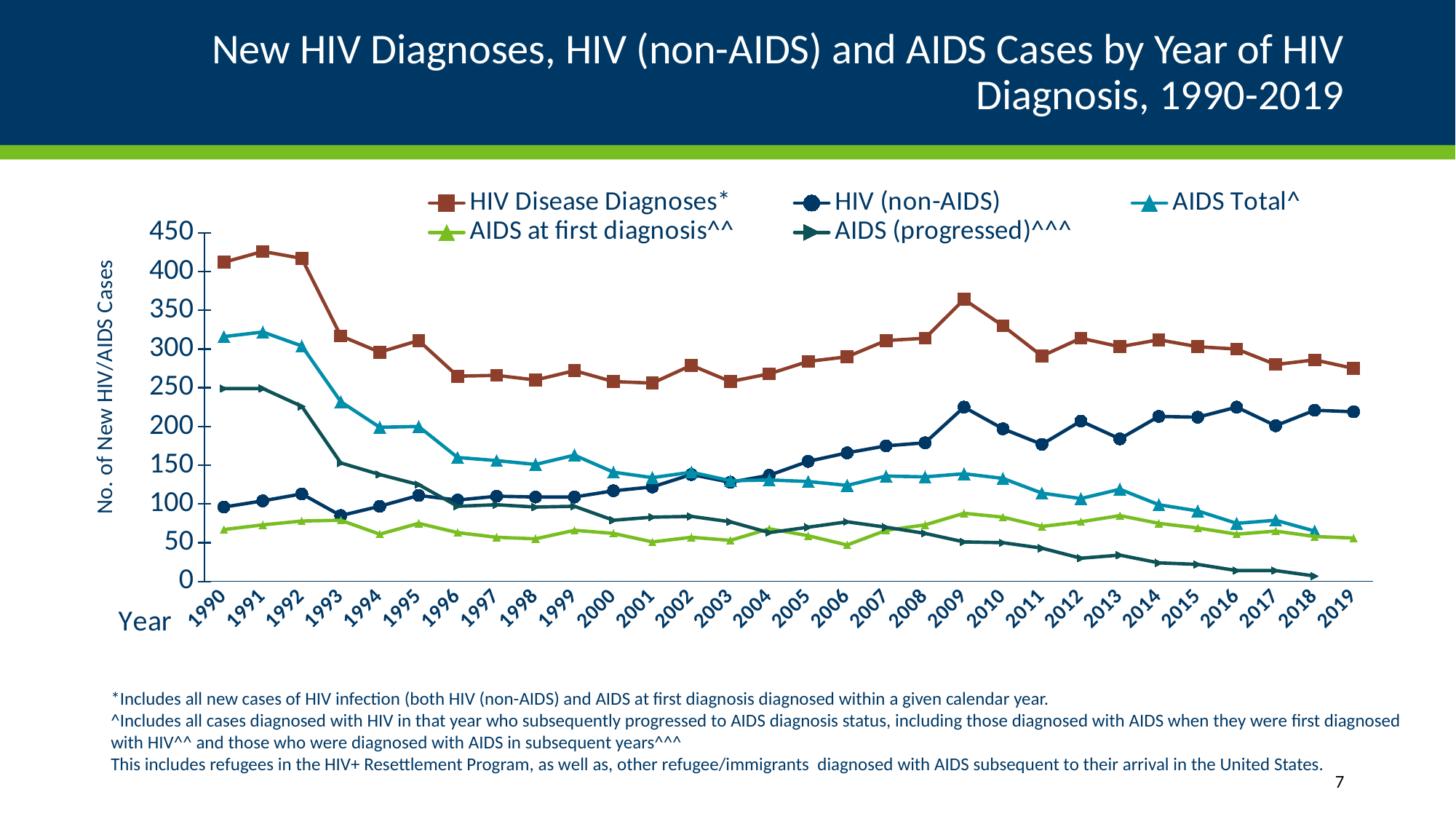
Is the value for HIV (non-AIDS) in 2009 greater or less than 200? greater What kind of chart is shown on the slide? line chart In which year is the HIV Disease Diagnoses* series at its highest? 1991 Is the value for HIV Disease Diagnoses* in 1990 greater or less than 400? greater How many years are plotted along the x axis? 30 Does the HIV (non-AIDS) series rise or fall from 1990 to 2019? rise Does the AIDS (progressed)^^^ series rise or fall from 1990 to 2019? fall What is the label on the y axis? No. of New HIV/AIDS Cases How many series does the legend list? 5 In which year is the AIDS (progressed)^^^ series at its lowest? 2018